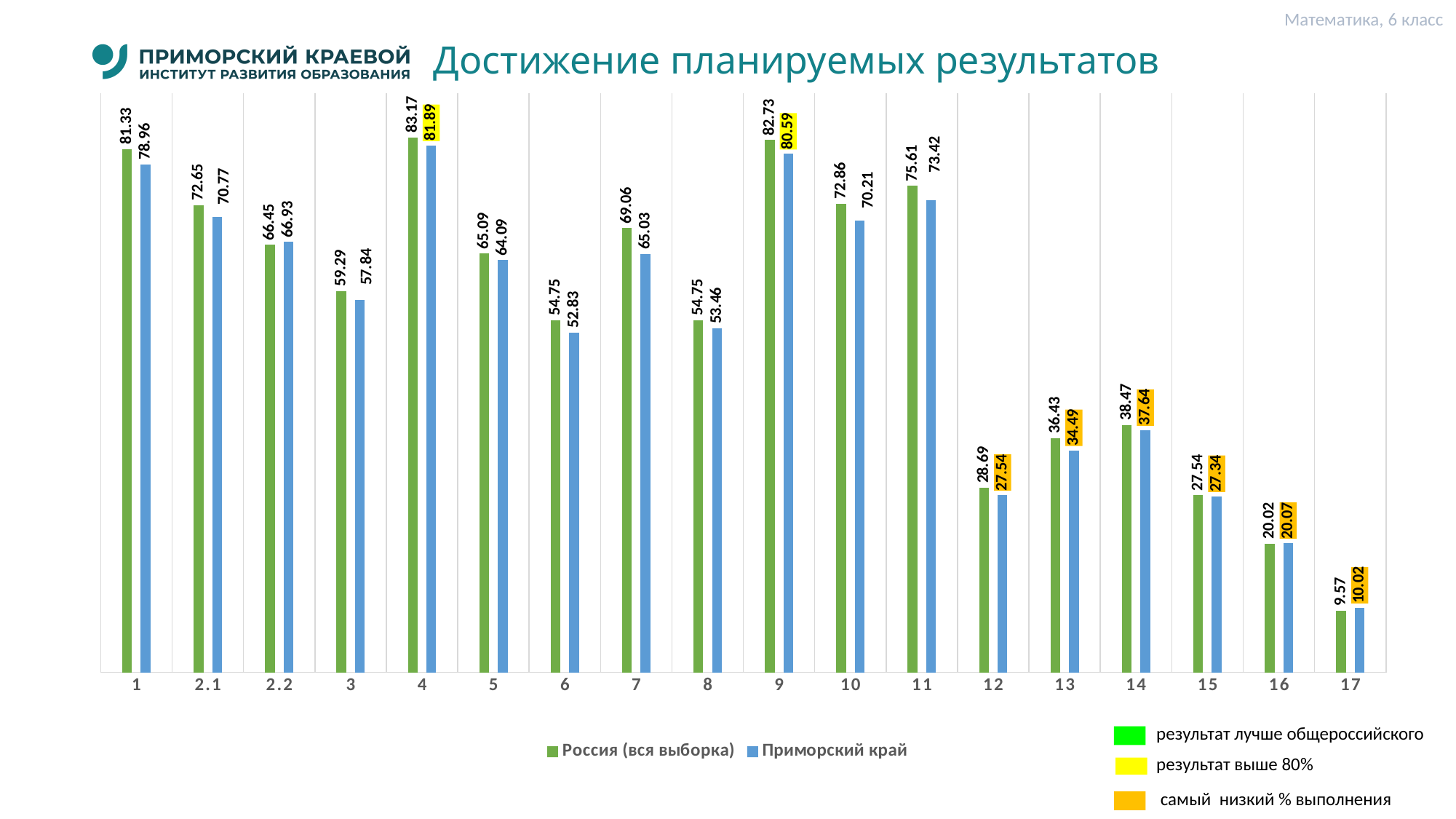
Which is larger: the Приморский край value for category 11 or for category 13? category 11 What is the value for Россия (вся выборка) for category 4? 83.17 Which category has the highest value for Россия (вся выборка)? 4 How many categories are shown on the x axis of the chart? 18 What is the difference between the Россия (вся выборка) and Приморский край values for category 7? 4.03 How many series does the chart legend list? 2 What is the title of the chart on the slide? Достижение планируемых результатов What type of chart is shown on the slide? bar chart Which category has the lowest value for Приморский край? 17 What is the value for Приморский край for category 17? 10.02 What is the value for Приморский край for category 9? 80.59 Which is larger for category 2.2: the value for Россия (вся выборка) or for Приморский край? Приморский край